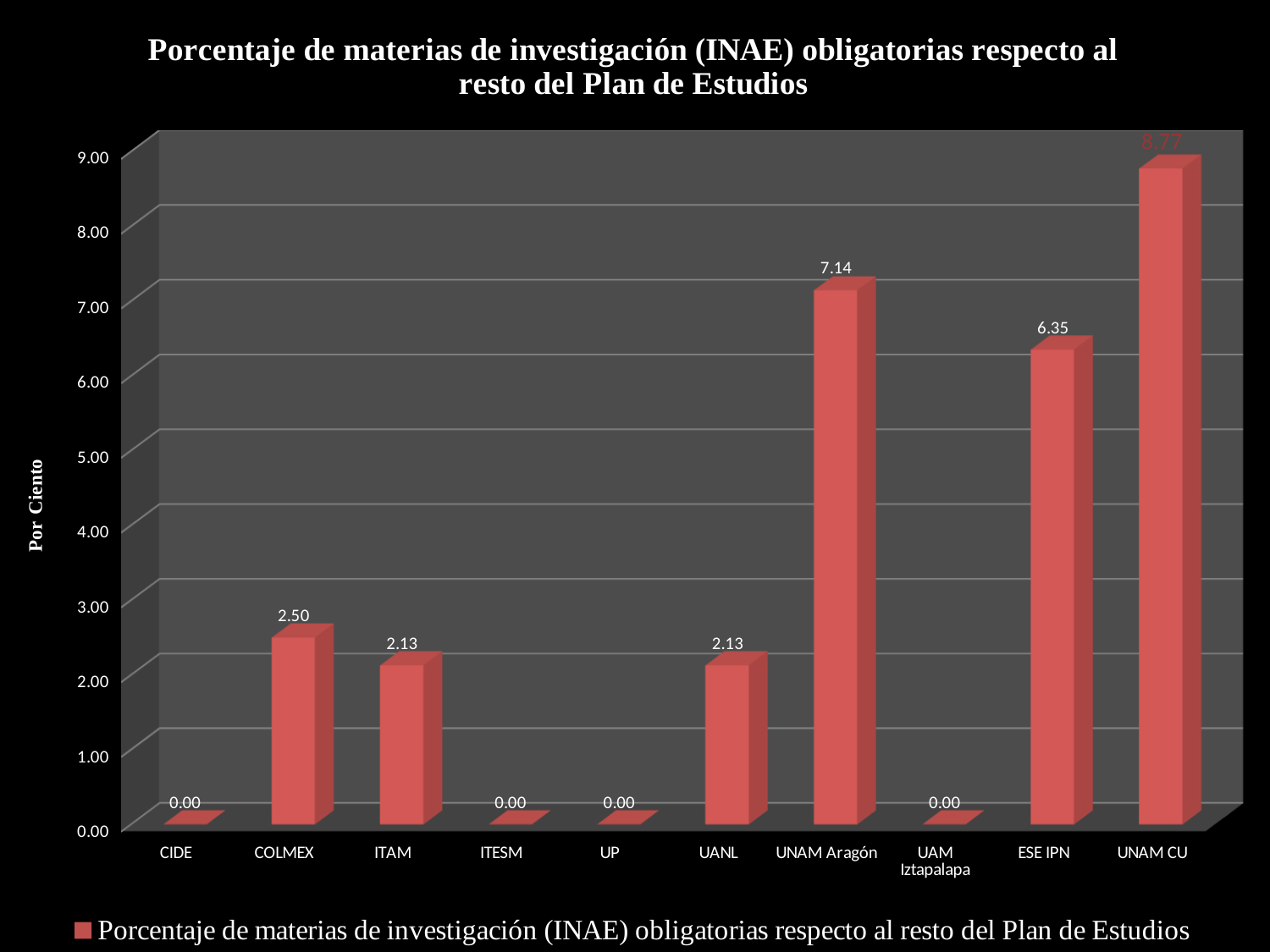
What is the value for COLMEX? 2.50 How many categories have a value of 0.00? 4 Which is larger, the value for ESE IPN or the value for UNAM Aragón? UNAM Aragón What is the value for ESE IPN? 6.35 What is the difference between the values for COLMEX and ITAM? 0.37 What is the label of the y axis? Por Ciento What is the difference between the values for UNAM CU and UNAM Aragón? 1.63 What is the value for UNAM Aragón? 7.14 How many categories are shown on the x axis? 10 Which category has the highest value? UNAM CU What is the value for UANL? 2.13 What kind of chart is shown on the slide? Bar chart